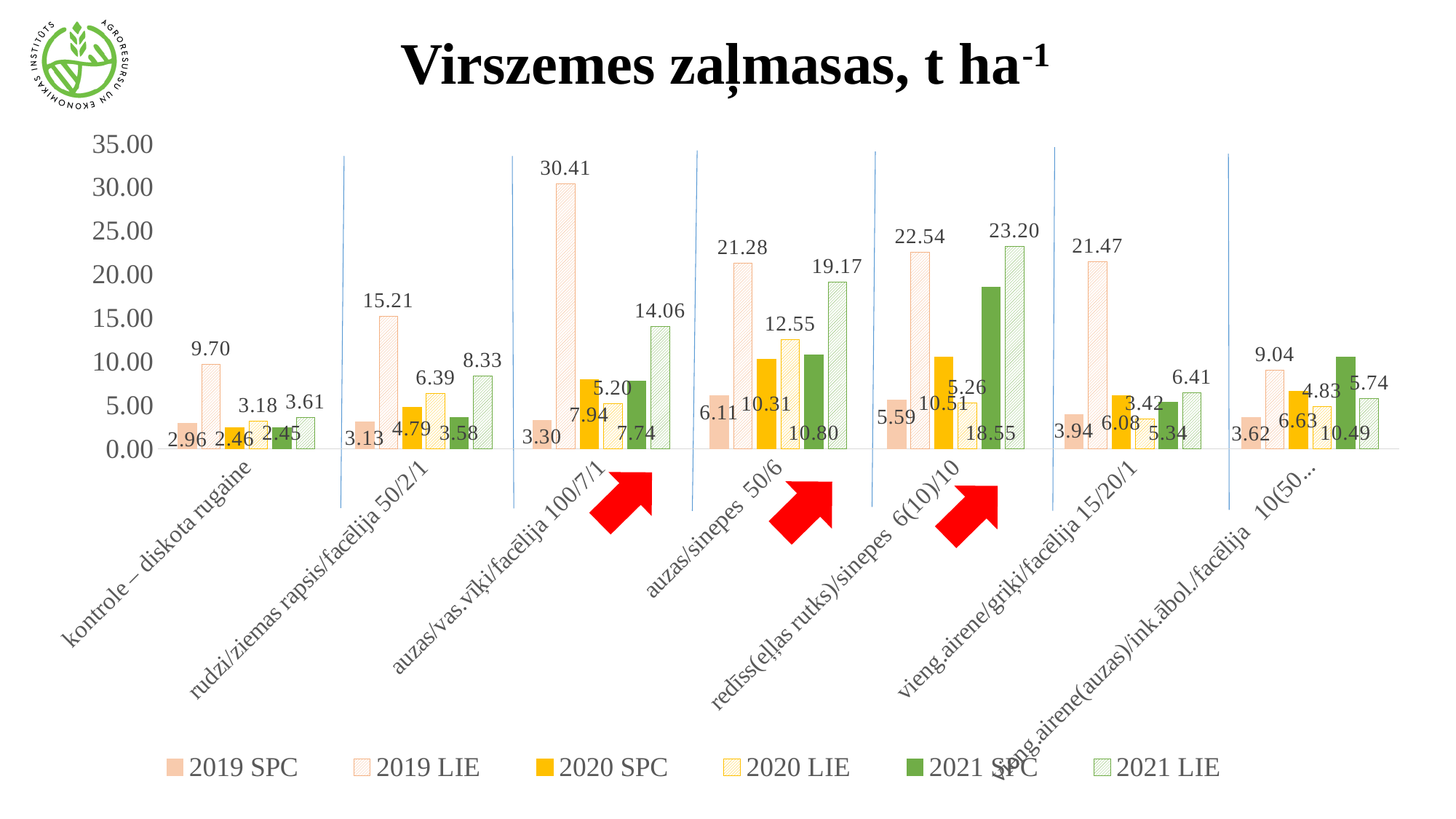
What is the value for 2020 LIE in the auzas/sinepes 50/6 category? 12.55 What is the value for 2021 SPC in the rediss(eļļas rutks)/sinepes 6(10)/10 category? 18.55 Which is larger in the auzas/sinepes 50/6 category: the 2019 LIE value or the 2021 LIE value? 2019 LIE Which category has the highest 2019 LIE value? auzas/vas.vīķi/facēlija 100/7/1 Is the 2019 LIE value for vieng.airene/griķi/facēlija 15/20/1 greater or less than 20.00? greater What is the value for 2019 LIE in the auzas/vas.vīķi/facēlija 100/7/1 category? 30.41 How many categories are shown on the x axis? 7 Which category has the lowest 2021 SPC value? kontrole – diskota rugaine What is the value for 2019 SPC in the kontrole – diskota rugaine category? 2.96 What is the difference between the 2021 LIE and 2021 SPC values in the rediss(eļļas rutks)/sinepes 6(10)/10 category? 4.65 What kind of chart is shown on the slide? bar chart How many series does the legend list? 6